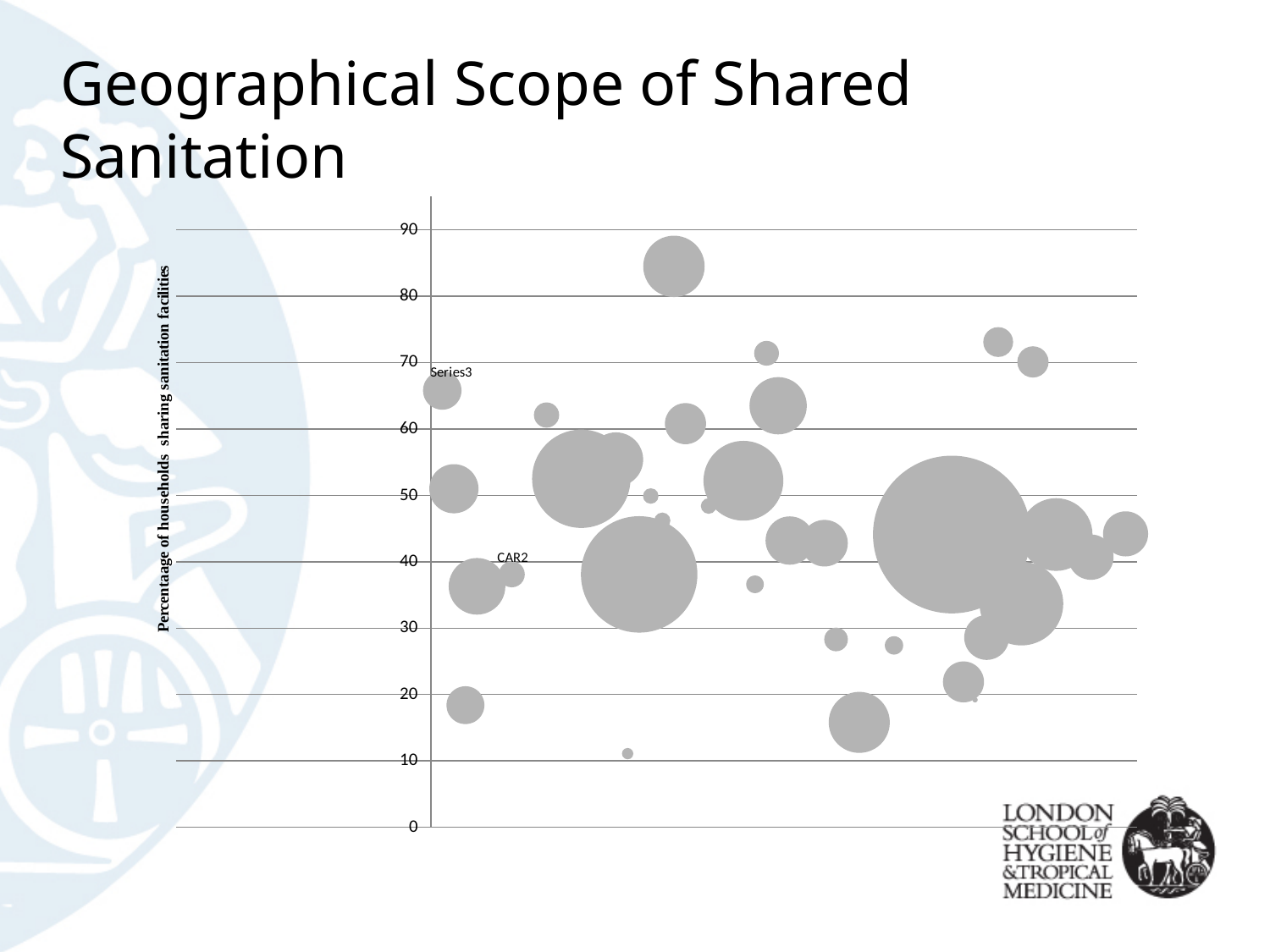
Is the value for the bubble labelled Series3 greater or less than 70? less Is the value for the bubble labelled CAR2 greater or less than 30? greater Is the value for the bubble labelled CAR2 greater or less than 50? less How many tick values are labelled on the vertical axis? 10 What is the title of the slide containing the chart? Geographical Scope of Shared Sanitation What is the label on the vertical axis of the chart? Percentage of households sharing sanitation facilities What is the lowest tick value shown on the vertical axis? 0 What kind of chart is shown on the slide? bubble chart What is the highest tick value shown on the vertical axis? 90 Which labelled bubble has the higher value, Series3 or CAR2? Series3